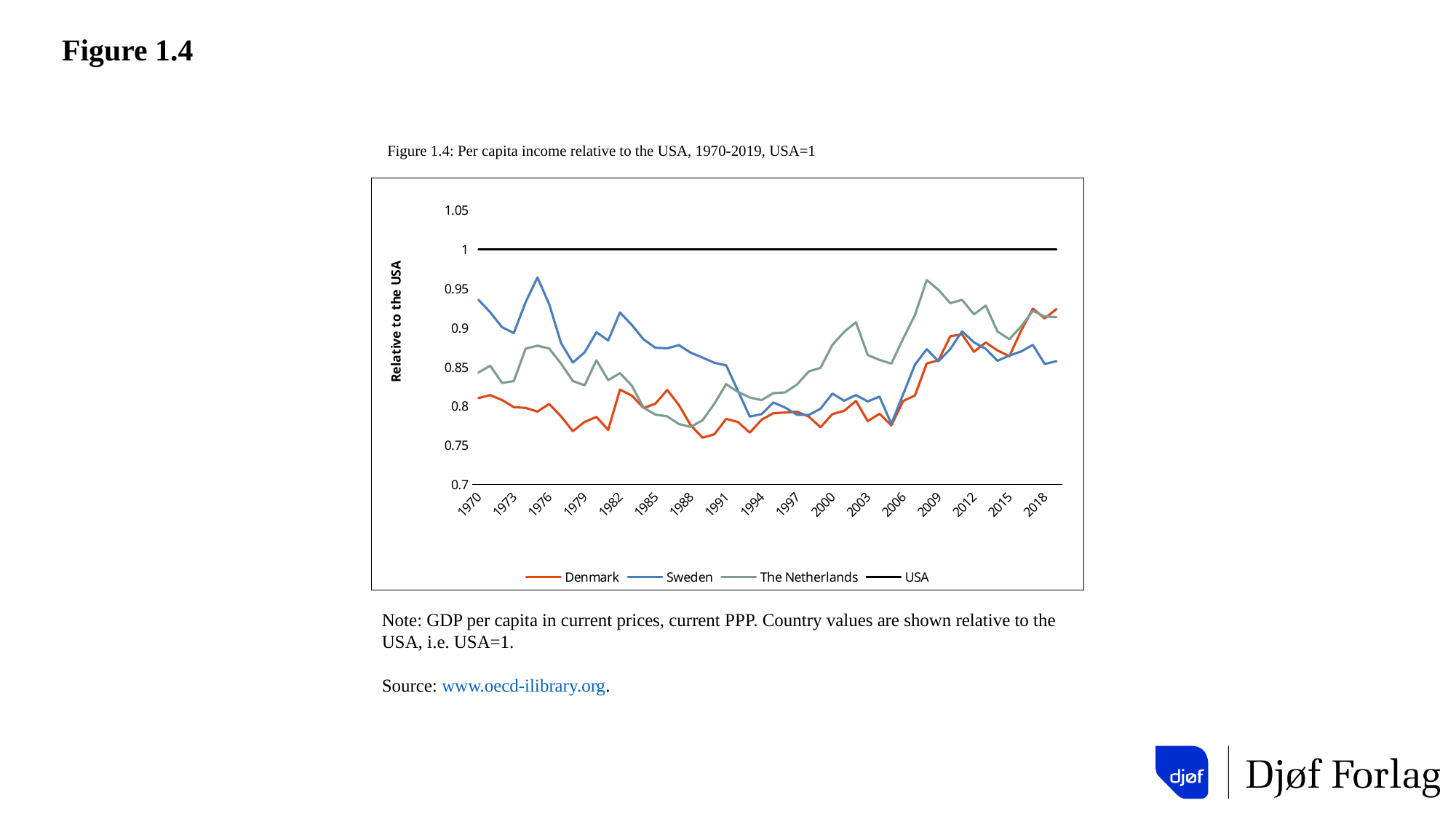
Does the Sweden series rise or fall between 1975 and 1979? fall Is the value for Denmark in 1990 greater or less than 0.8? less What value does the USA series take throughout the chart? 1 Apart from the USA, which country has the highest value in 1975? Sweden In 2008, which is higher: The Netherlands or Denmark? The Netherlands In 1970, which is higher: Sweden or Denmark? Sweden Is the value for Sweden in 1975 greater or less than 0.95? greater How many series does the legend list? 4 What kind of chart is shown on the slide? line chart What is the title of the chart? Figure 1.4: Per capita income relative to the USA, 1970-2019, USA=1 What is the title of the vertical axis? Relative to the USA Which country has the lowest value in 1970? Denmark